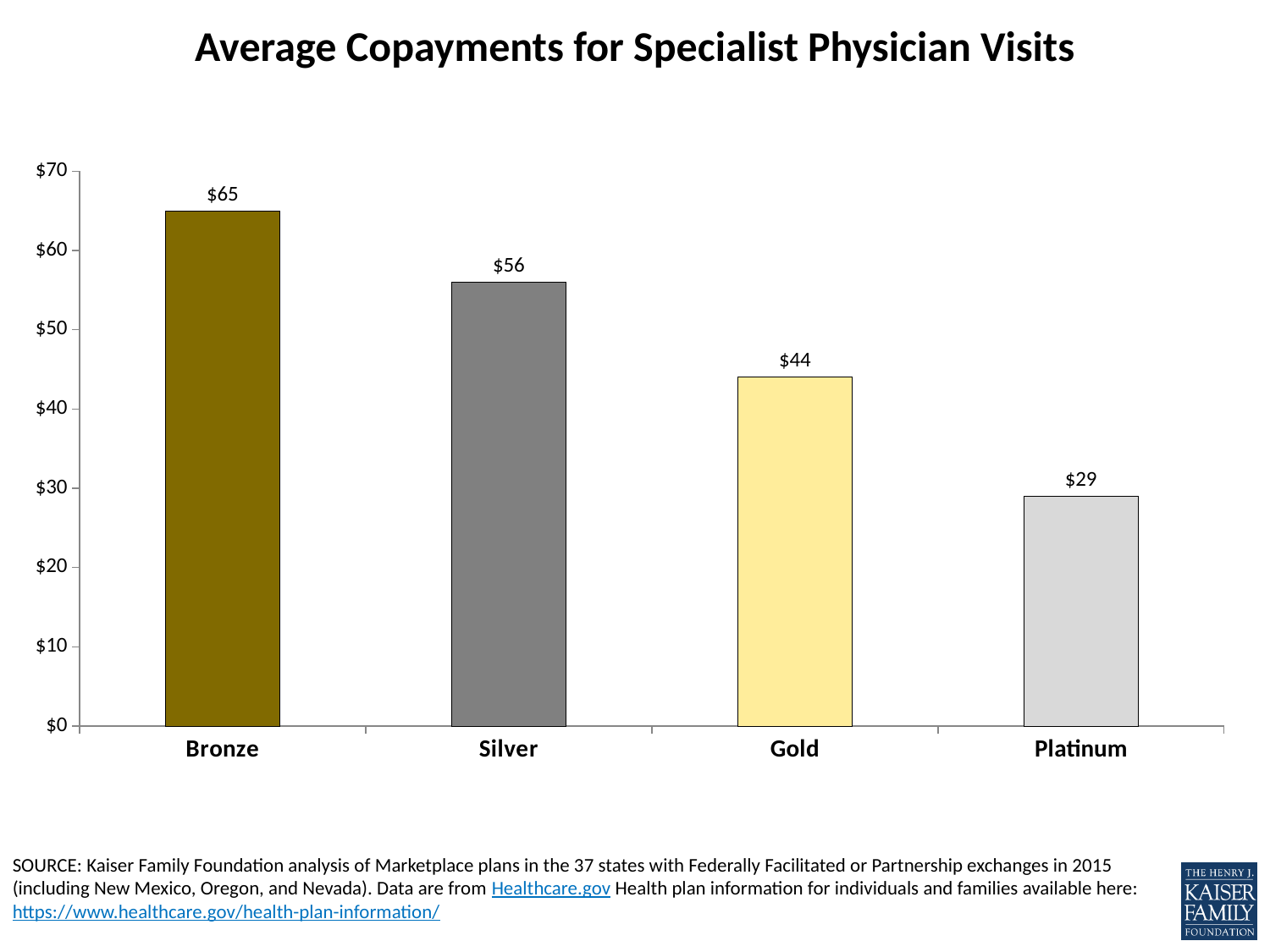
Which has a higher average copayment, Gold or Silver? Silver What is the average copayment for specialist physician visits for Bronze plans? $65 What is the average copayment for specialist physician visits for Silver plans? $56 What kind of chart is shown on the slide? Bar chart Which plan type has the highest average copayment for specialist physician visits? Bronze Which plan type has the lowest average copayment for specialist physician visits? Platinum What is the difference between the average copayments for Bronze and Platinum plans? $36 What is the average copayment for specialist physician visits for Platinum plans? $29 Do the average copayments rise or fall moving from Bronze to Platinum along the x axis? Fall What is the average copayment for specialist physician visits for Gold plans? $44 What is the difference between the average copayments for Silver and Gold plans? $12 How many plan types are shown in the chart? 4